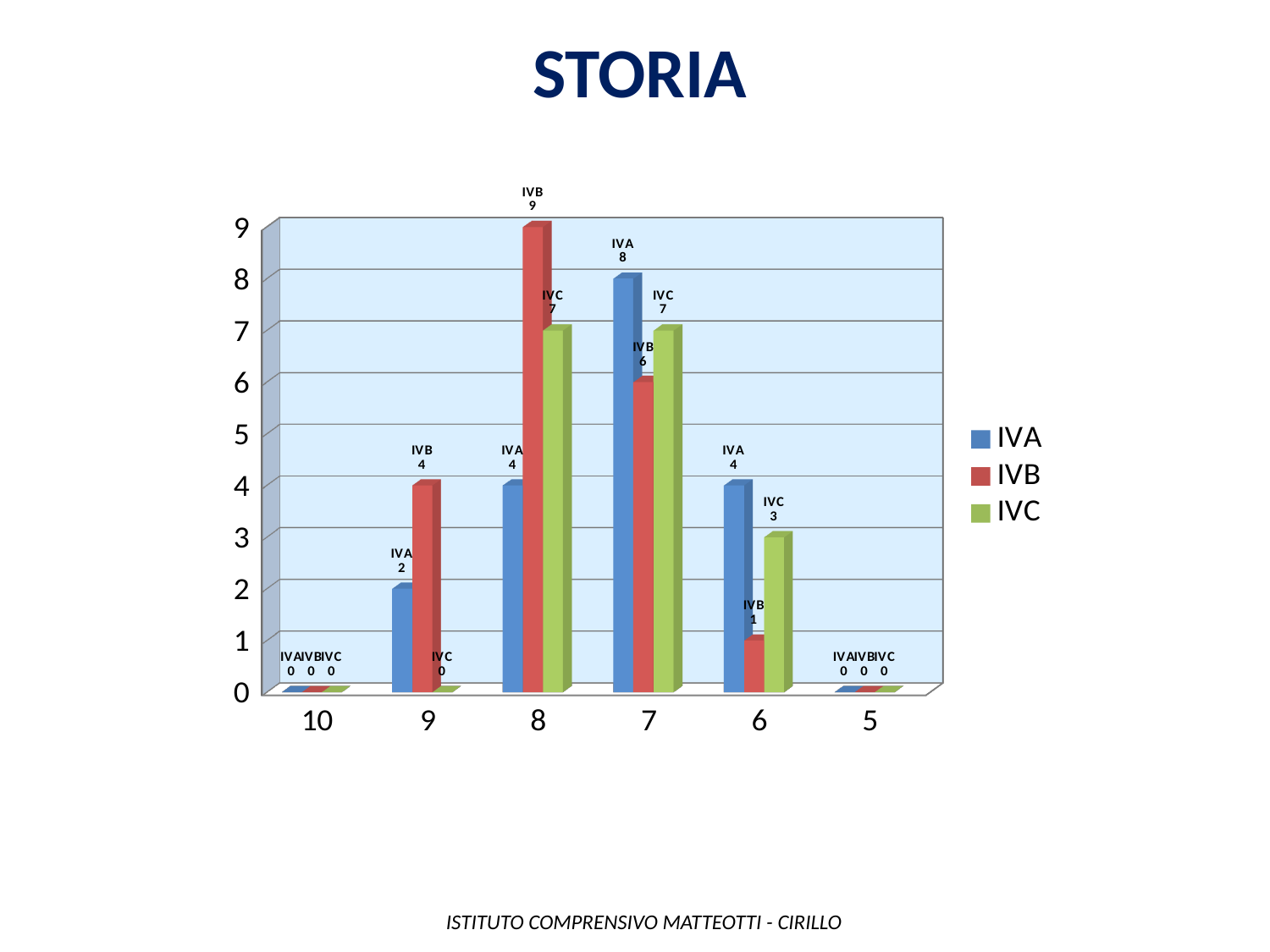
What kind of chart is shown on the slide? bar chart What is the value for IVA at grade 9? 2 What is the value for IVC at grade 6? 3 How many grade categories are shown on the x axis? 6 For which grade is the IVA value highest? 7 Which is larger at grade 7: the IVA value or the IVB value? IVA What is the title of the chart? STORIA What is the value for IVB at grade 8? 9 How many series does the legend list? 3 What is the value for IVA at grade 7? 8 For which grade is the IVB value highest? 8 What is the difference between the IVB and IVA values at grade 8? 5